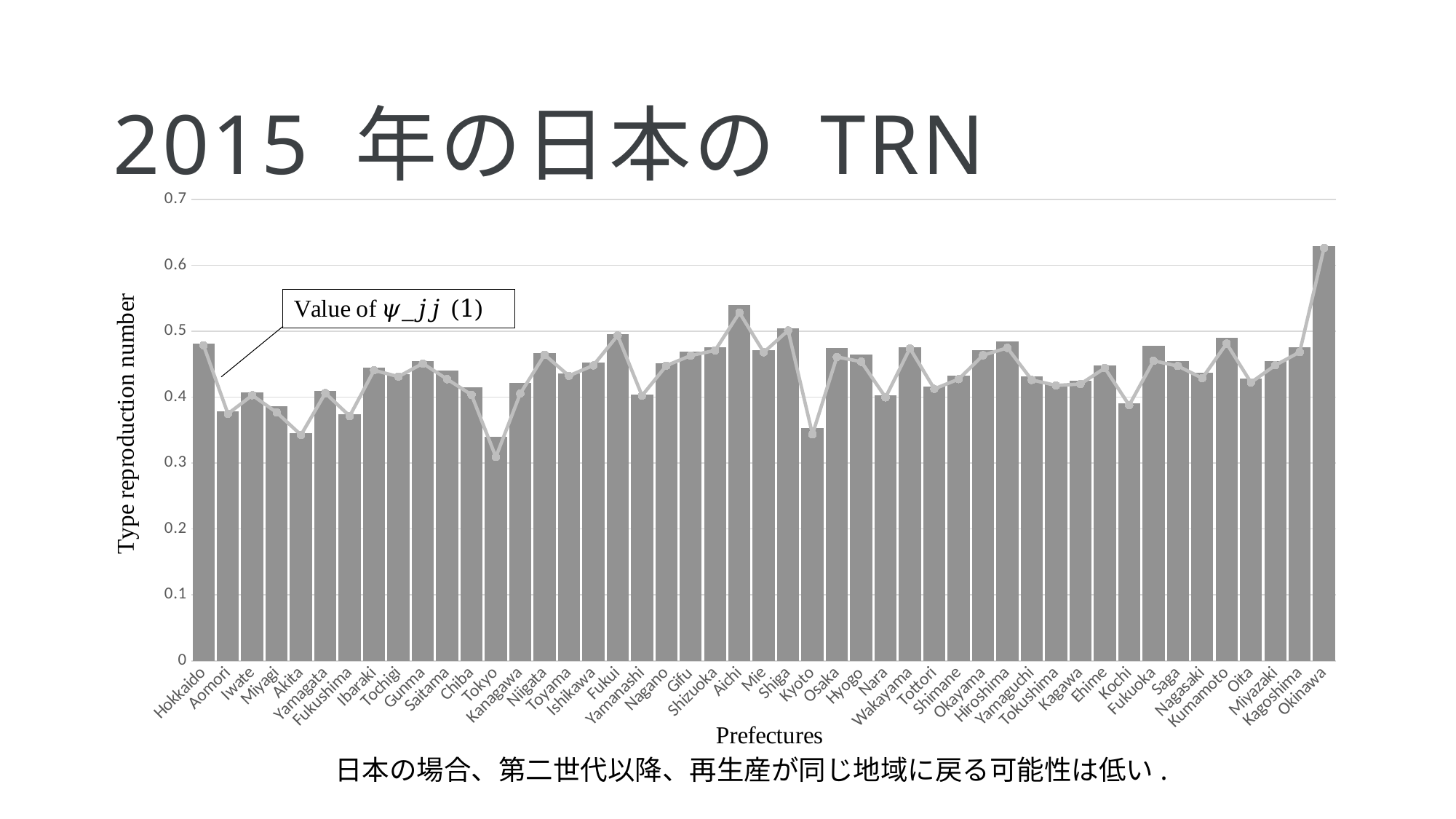
What kind of chart is shown on the slide? combination bar and line chart Is the value for Tokyo greater or less than 0.4? less Is the value for Akita greater or less than 0.4? less Is the value for Hokkaido greater or less than 0.5? less Which prefecture has the highest type reproduction number in the chart? Okinawa How many prefectures are plotted along the x axis? 47 What is the label of the vertical axis? Type reproduction number Which has the larger value, Okinawa or Hokkaido? Okinawa What is the label of the horizontal axis? Prefectures